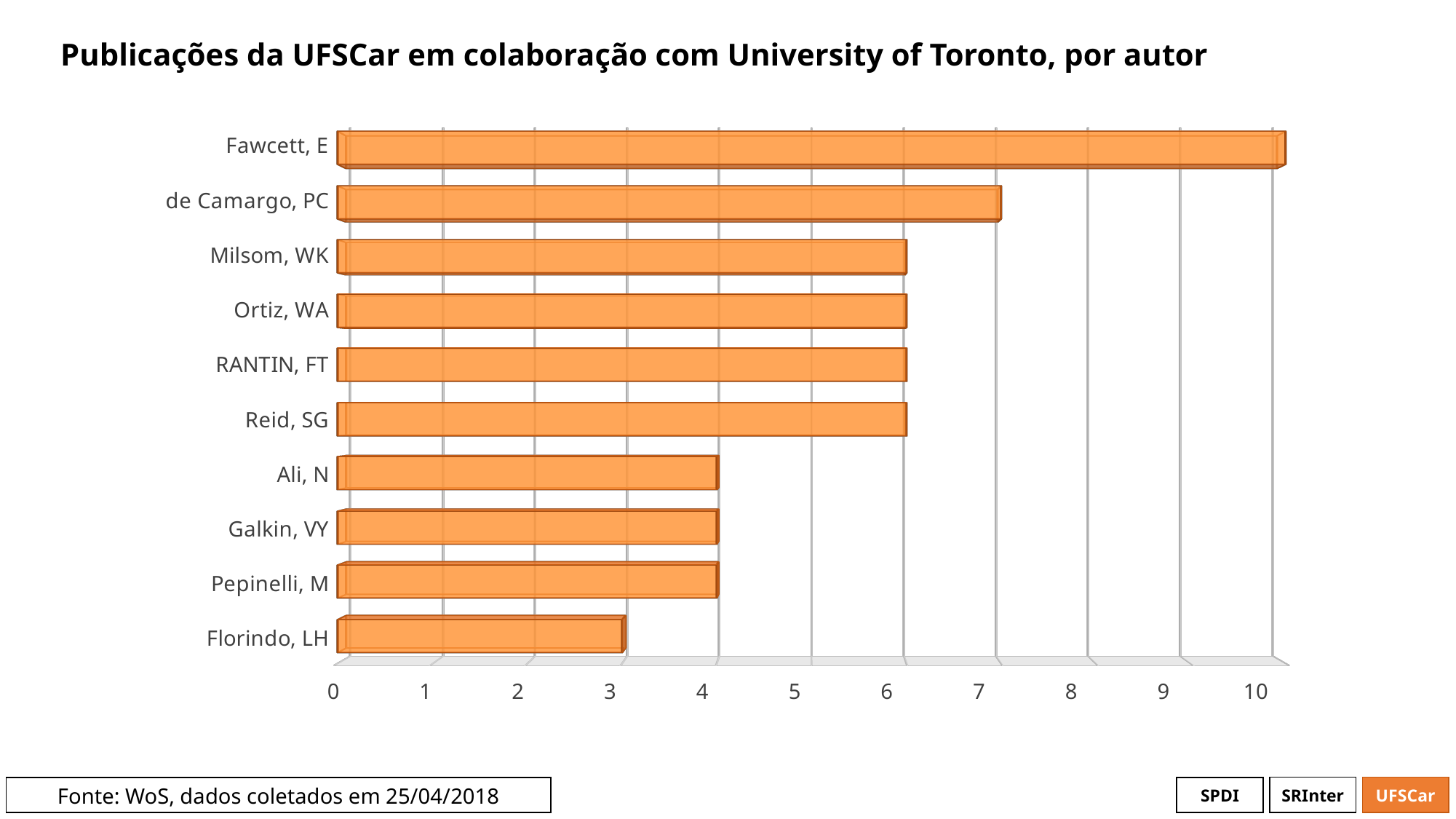
Is the value for Fawcett, E greater or less than 9? greater How many publications does de Camargo, PC have? 7 Which author has the lowest number of publications? Florindo, LH Who has more publications, de Camargo, PC or Milsom, WK? de Camargo, PC How many authors are shown in the chart? 10 Which author has the highest number of publications? Fawcett, E What is the title of the chart? Publicações da UFSCar em colaboração com University of Toronto, por autor Is the value for Florindo, LH greater or less than 4? less What is the difference in publications between Fawcett, E and Florindo, LH? 7 What kind of chart is shown on the slide? bar chart How many publications does Fawcett, E have? 10 How many publications does Florindo, LH have? 3